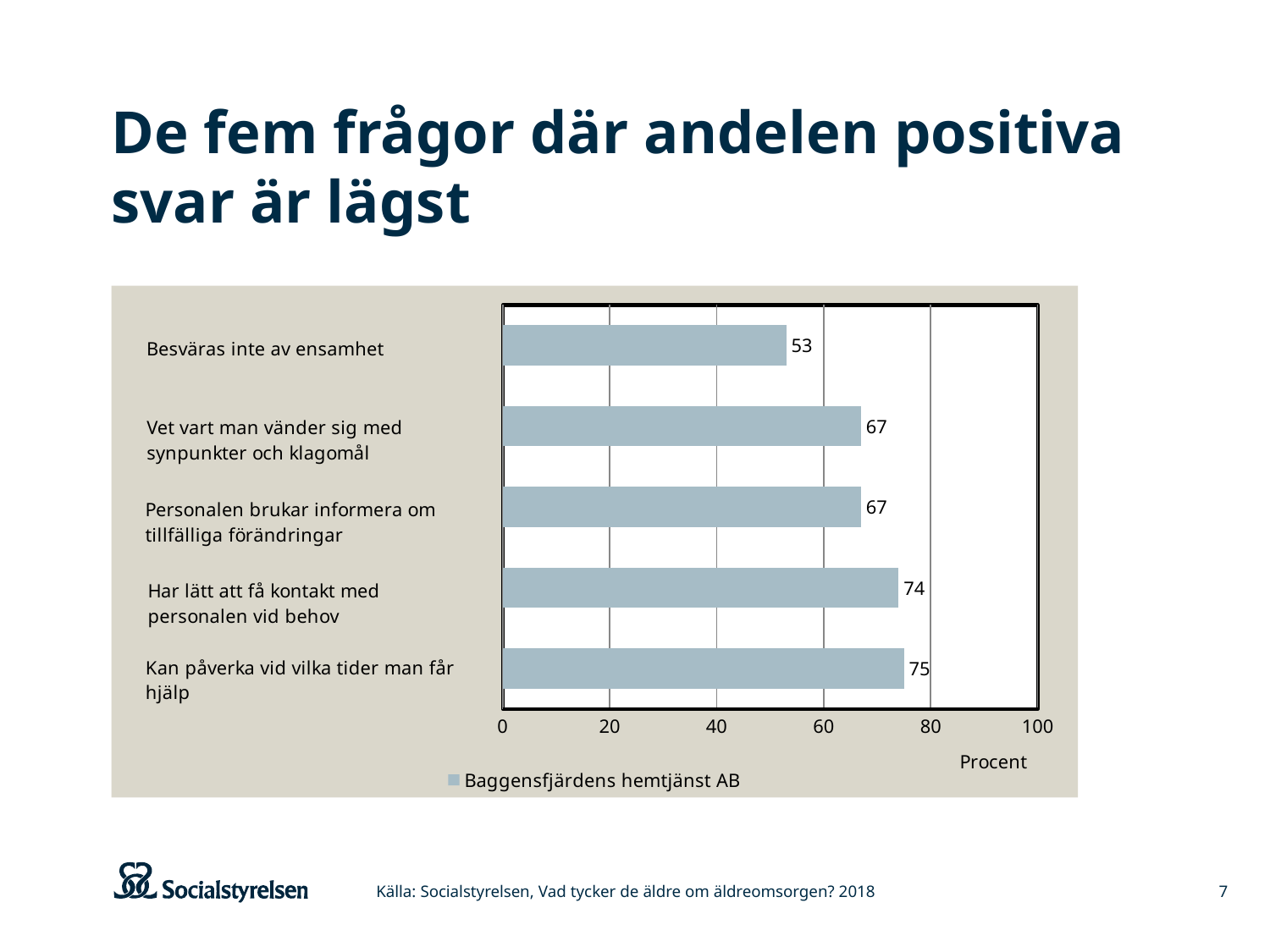
What kind of chart is shown on the slide? Bar chart What series name is shown in the legend? Baggensfjärdens hemtjänst AB Is the value for "Har lätt att få kontakt med personalen vid behov" greater or less than 60? greater Which category has the lowest value? Besväras inte av ensamhet How many categories are shown in the chart? 5 What is the value for "Har lätt att få kontakt med personalen vid behov"? 74 How many series does the legend list? 1 What is the value for "Personalen brukar informera om tillfälliga förändringar"? 67 What is the difference between the values for "Kan påverka vid vilka tider man får hjälp" and "Besväras inte av ensamhet"? 22 What is the value for "Besväras inte av ensamhet"? 53 Which is larger: the value for "Vet vart man vänder sig med synpunkter och klagomål" or the value for "Besväras inte av ensamhet"? Vet vart man vänder sig med synpunkter och klagomål What is the value for "Kan påverka vid vilka tider man får hjälp"? 75